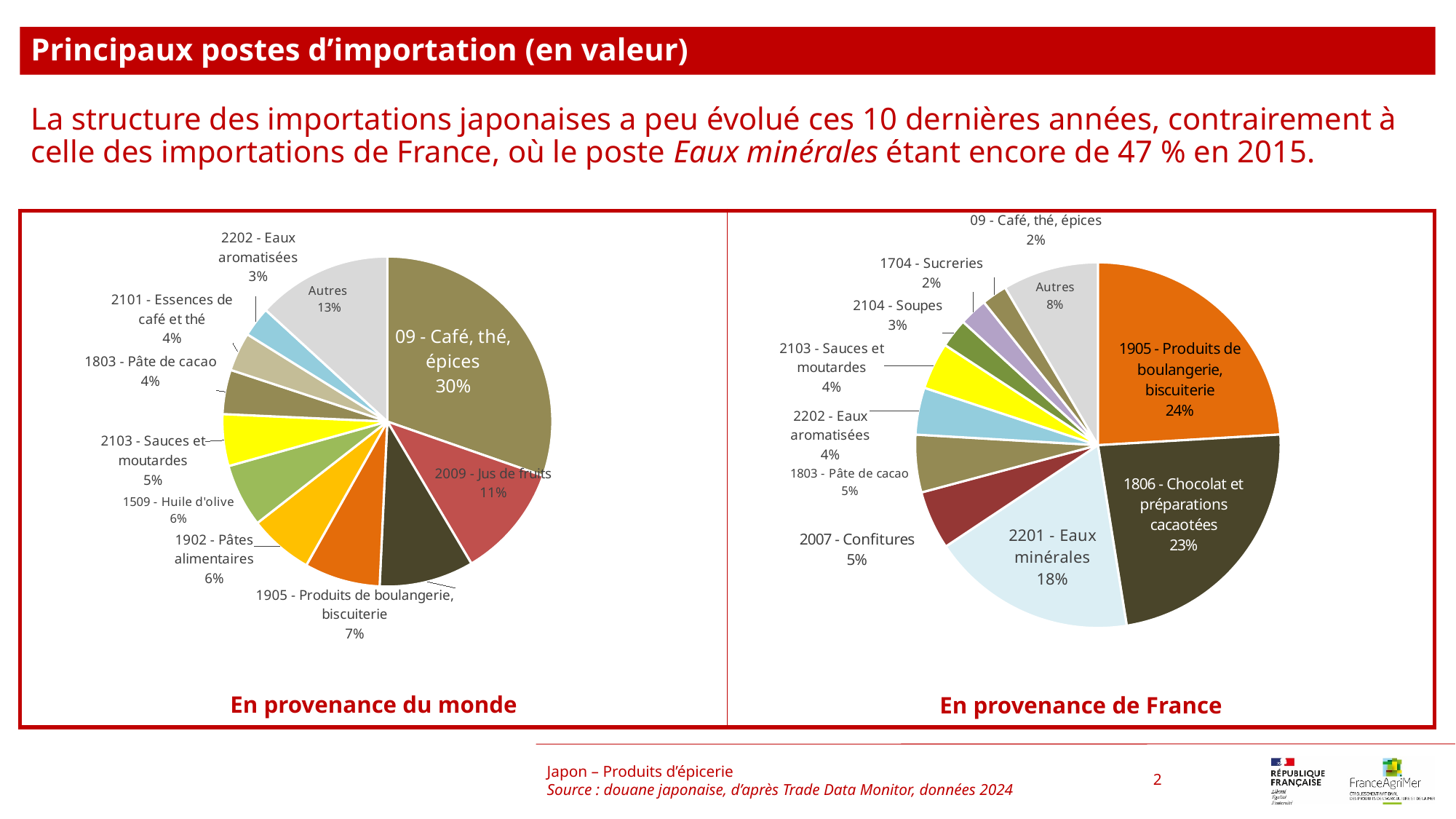
In the chart 'En provenance du monde', which category has the largest share? 09 - Café, thé, épices In the chart 'En provenance du monde', what share does 'Autres' have? 13% In the chart 'En provenance du monde', what is the difference in share between '09 - Café, thé, épices' and '2009 - Jus de fruits'? 19 percentage points In the chart 'En provenance du monde', what share does '2009 - Jus de fruits' have? 11% In the chart 'En provenance de France', what share does '2201 - Eaux minérales' have? 18% In the chart 'En provenance de France', which is larger: '1806 - Chocolat et préparations cacaotées' or '2201 - Eaux minérales'? 1806 - Chocolat et préparations cacaotées In the chart 'En provenance de France', what share does '2104 - Soupes' have? 3% In the chart 'En provenance de France', what is the difference in share between '1905 - Produits de boulangerie, biscuiterie' and '1806 - Chocolat et préparations cacaotées'? 1 percentage point In the chart 'En provenance du monde', what share does '09 - Café, thé, épices' have? 30% In the chart 'En provenance de France', how many slices does the pie have? 11 In the chart 'En provenance de France', what share does '1905 - Produits de boulangerie, biscuiterie' have? 24% What type of chart is used on this slide? Pie chart